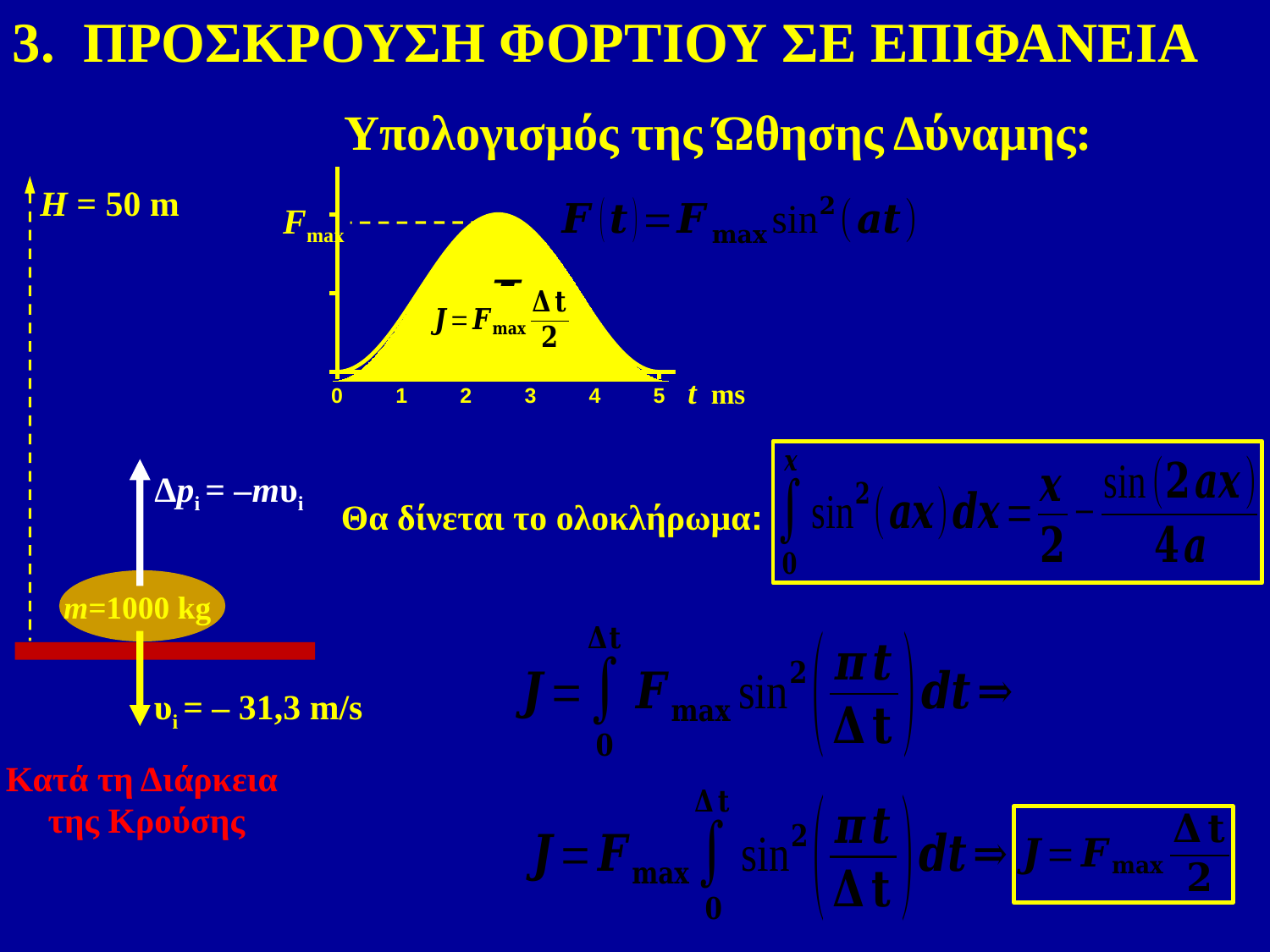
What kind of chart is shown on the slide? area chart Which is larger, the value of the curve at t = 1 ms or at t = 2 ms? t = 2 ms What is the largest value labelled on the x axis of the chart? 5 How many tick marks are labelled on the x axis of the chart? 6 Which is larger, the value of the curve at t = 3 ms or at t = 4 ms? t = 3 ms Is the value of the curve at t = 1 ms greater or less than F_max? less Does the curve rise or fall between t = 3 and t = 5 ms? fall Is the value of the curve at t = 5 ms greater or less than F_max? less Does the curve rise or fall between t = 0 and t = 2 ms? rise What unit is shown on the x axis of the chart? ms What label is shown on the y axis of the chart? F_max Which is larger, the value of the curve at t = 2 ms or at t = 5 ms? t = 2 ms